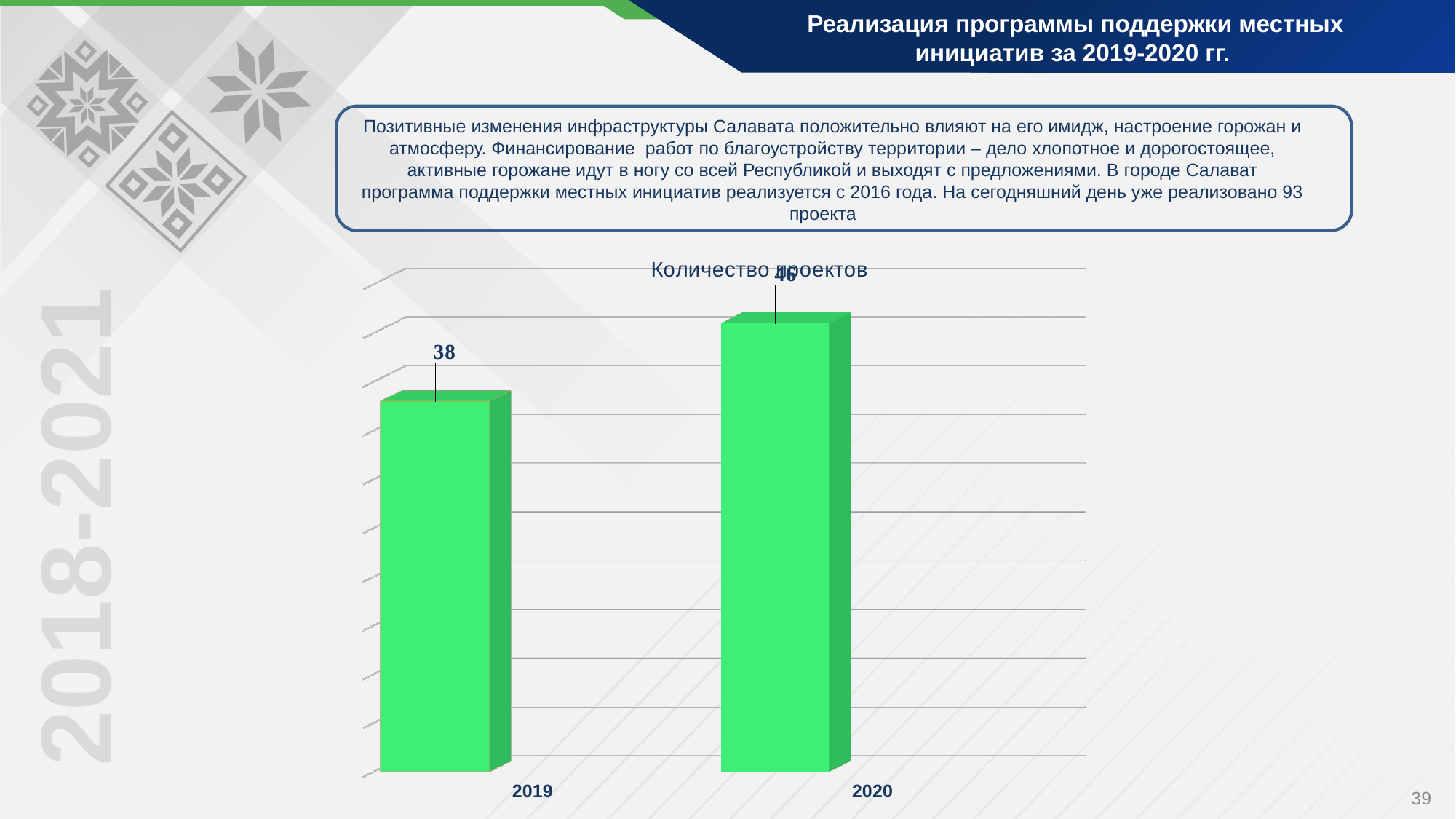
What is the value for 2019 in the chart? 38 How many categories are shown on the x axis of the chart? 2 What is the value for 2020 in the chart? 46 What is the title of the chart? Количество проектов Which is larger, the value for 2019 or the value for 2020? 2020 Which year has the highest value in the chart? 2020 What colour are the bars in the chart? green Do the values rise or fall from 2019 to 2020? rise What is the difference between the values for 2020 and 2019? 8 Which year has the lowest value in the chart? 2019 What kind of chart is shown on the slide? bar chart